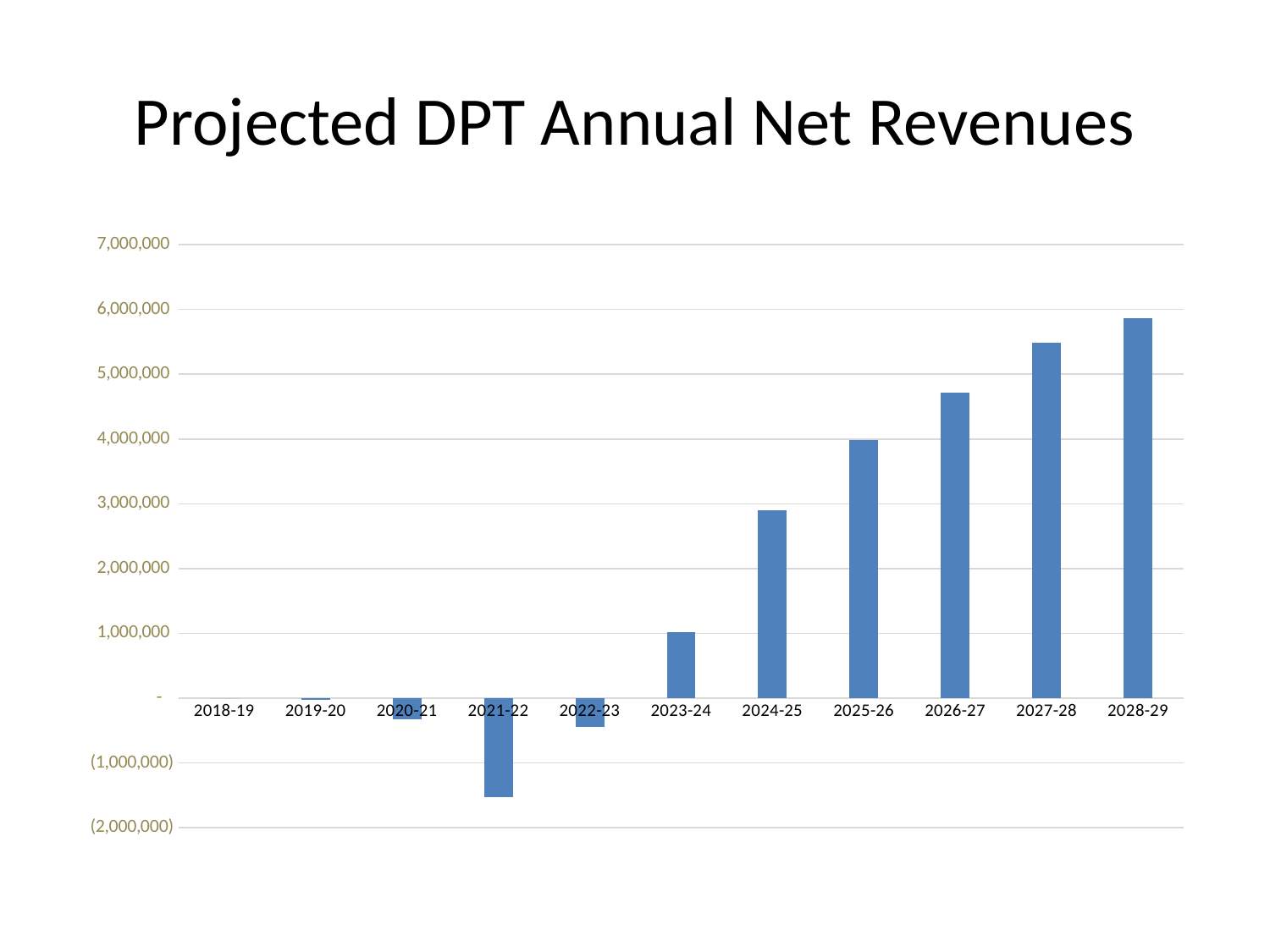
Is the value for 2024-25 greater or less than 2,000,000? greater Which is larger, the value for 2027-28 or the value for 2026-27? 2027-28 Do the values rise or fall from 2023-24 to 2028-29? rise What type of chart is shown on the slide? bar chart Which is larger, the value for 2023-24 or the value for 2025-26? 2025-26 Is the value for 2026-27 greater or less than 4,000,000? greater Which fiscal year has the highest projected net revenue? 2028-29 Is the value for 2028-29 greater or less than 5,000,000? greater How many fiscal years are shown on the x axis of the chart? 11 What is the title of the chart? Projected DPT Annual Net Revenues Which fiscal year has the lowest projected net revenue? 2021-22